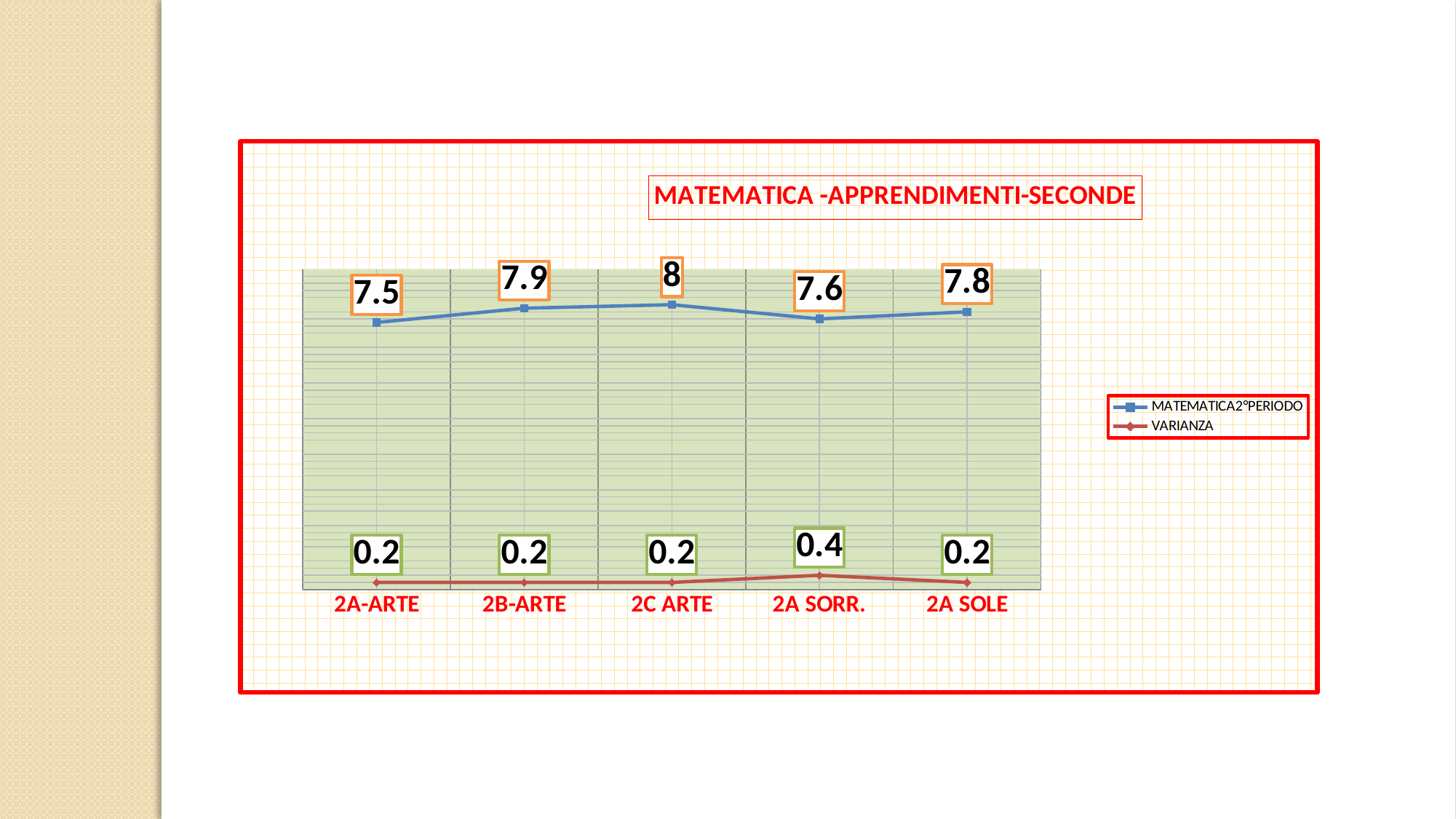
Which category has the highest VARIANZA value? 2A SORR. Which category has the lowest MATEMATICA2°PERIODO value? 2A-ARTE Which is larger, the MATEMATICA2°PERIODO value for 2B-ARTE or for 2A SORR.? 2B-ARTE What is the difference between the MATEMATICA2°PERIODO values for 2C ARTE and 2A-ARTE? 0.5 How many categories are shown on the x axis? 5 How many series does the legend list? 2 What is the MATEMATICA2°PERIODO value for 2A-ARTE? 7.5 What is the MATEMATICA2°PERIODO value for 2C ARTE? 8 Which category has the highest MATEMATICA2°PERIODO value? 2C ARTE What is the VARIANZA value for 2B-ARTE? 0.2 What type of chart is shown? Line chart What is the VARIANZA value for 2A SORR.? 0.4